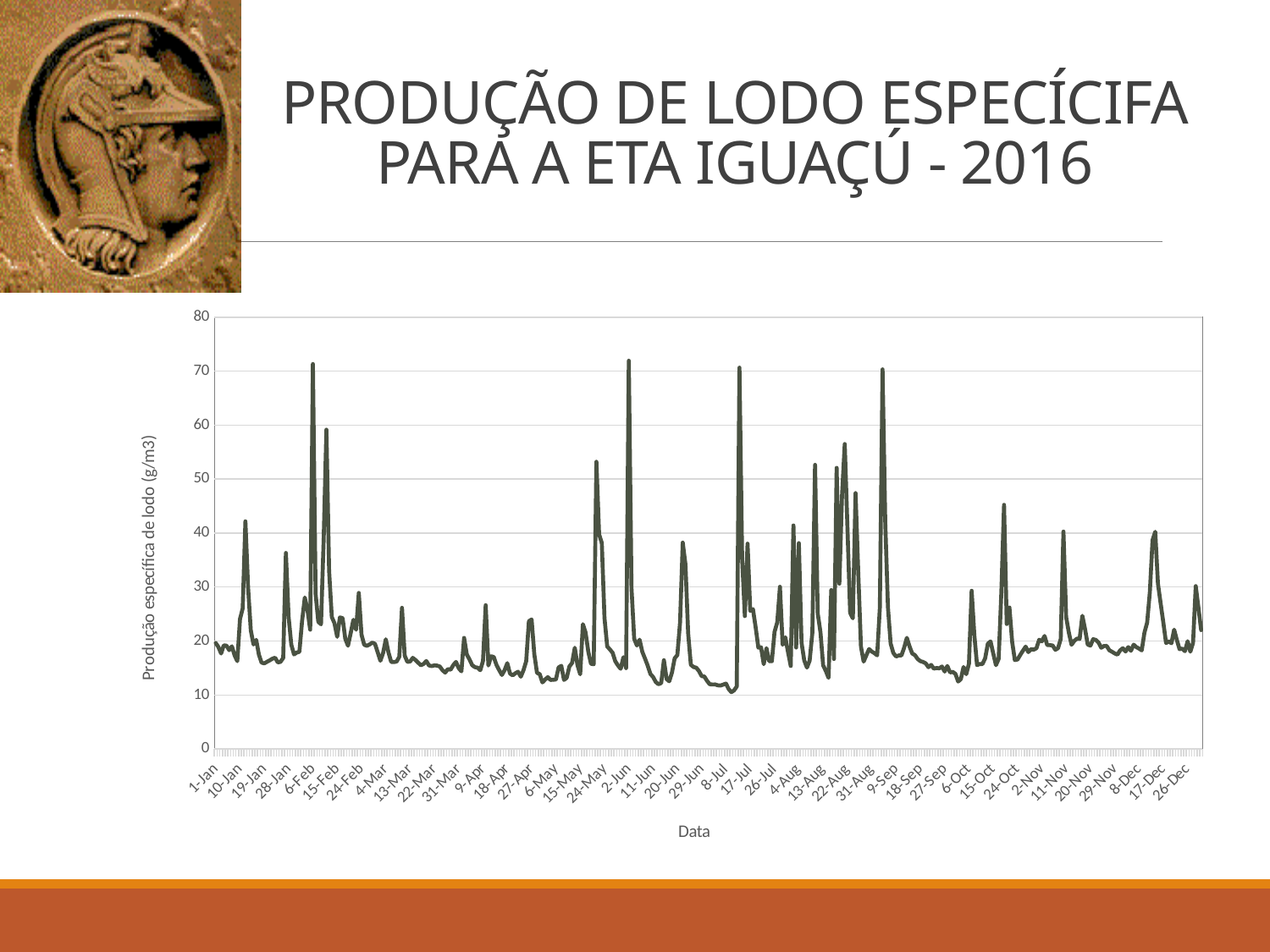
Is the value on 1-Jan greater or less than 30? less Is the value on 26-Dec greater or less than 30? less Is the peak near 6-Feb greater or less than 60? greater How many data series are plotted in the chart? 1 What is the title of the y axis of the chart? Produção específica de lodo (g/m3) What is the title of the x axis of the chart? Data What kind of chart is shown on the slide? line chart